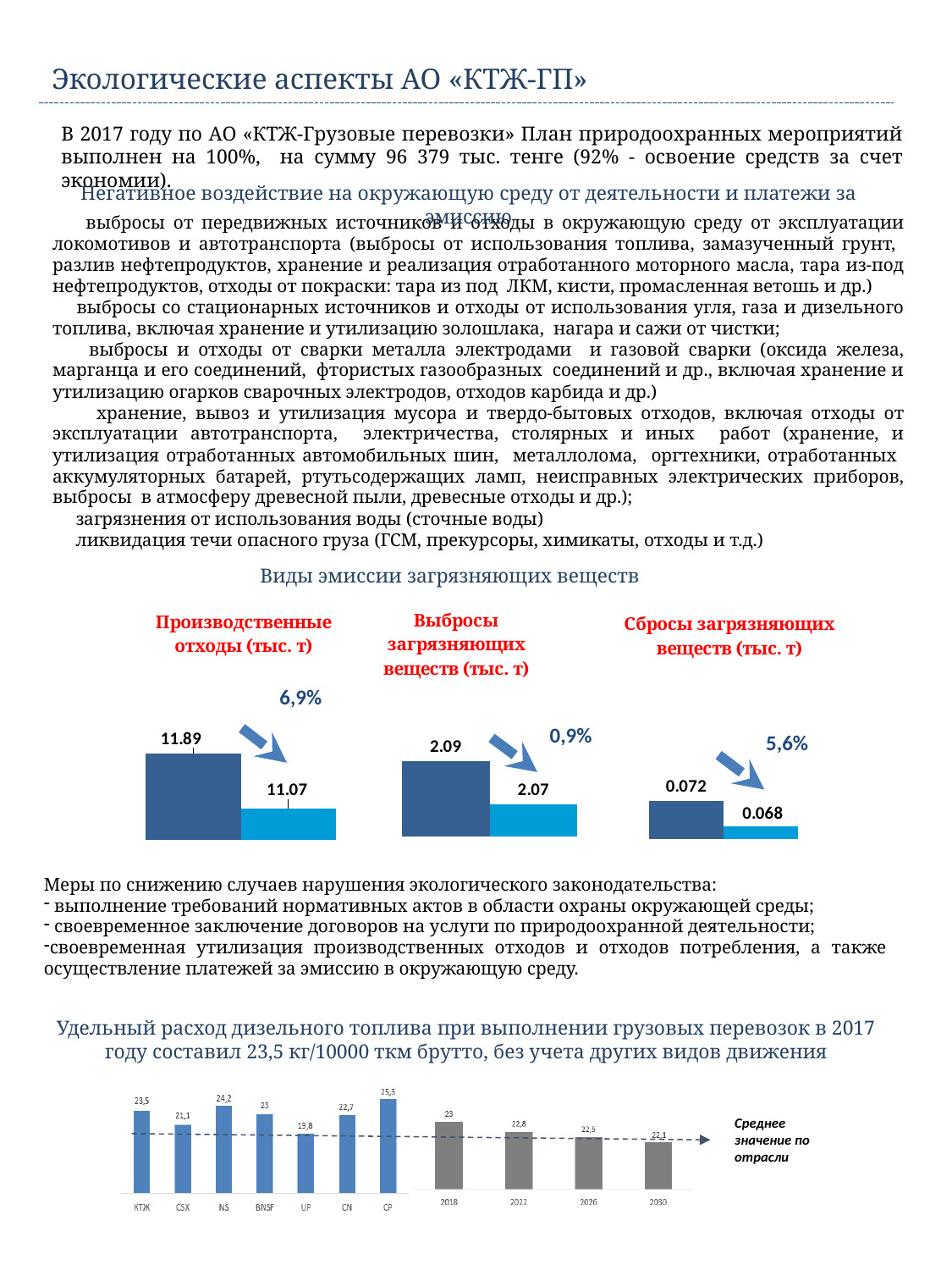
In the bottom chart on diesel fuel consumption, what is the value for КТЖ? 23,5 In the 'Сбросы загрязняющих веществ (тыс. т)' chart, what percentage decrease is shown next to the arrow? 5,6% In the bottom chart on diesel fuel consumption, which railway company has the highest value? CP In the 'Производственные отходы (тыс. т)' chart, do the values rise or fall from the first bar to the second? fall In the 'Производственные отходы (тыс. т)' chart, what is the value of the first (dark blue) bar? 11.89 In the bottom chart on diesel fuel consumption, what is the value for 2030? 22,1 In the 'Сбросы загрязняющих веществ (тыс. т)' chart, what is the value of the first (dark blue) bar? 0.072 In the bottom chart on diesel fuel consumption, which railway company has the lowest value? UP In the 'Производственные отходы (тыс. т)' chart, what is the value of the second (light blue) bar? 11.07 In the 'Выбросы загрязняющих веществ (тыс. т)' chart, what is the difference between the two bars? 0.02 What type of chart is the bottom chart on diesel fuel consumption? bar chart In the 'Выбросы загрязняющих веществ (тыс. т)' chart, what is the value of the second (light blue) bar? 2.07